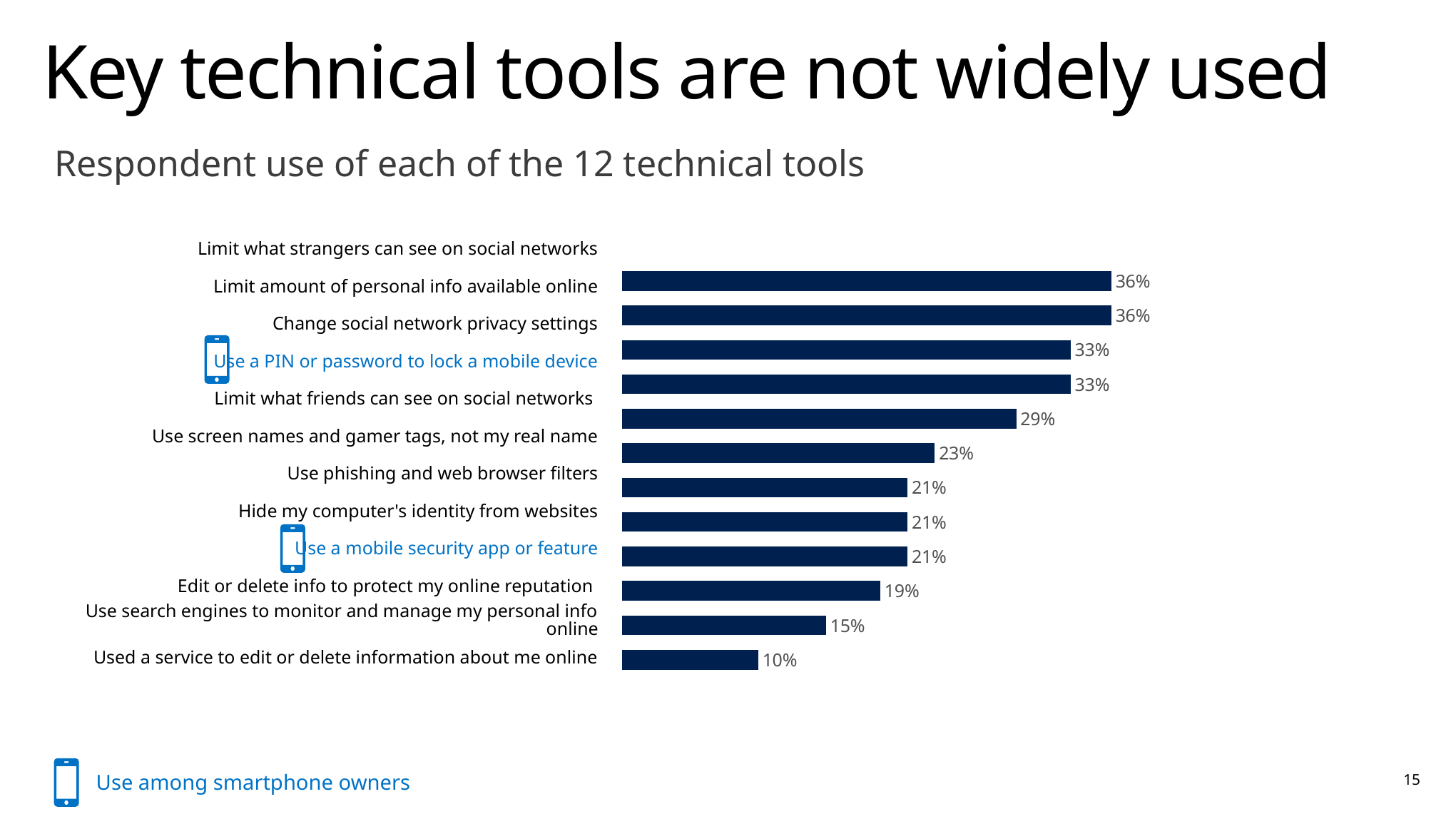
What is the value for "Edit or delete info to protect my online reputation"? 19% What is the value for "Use a mobile security app or feature"? 21% What is the value for "Limit amount of personal info available online"? 36% What kind of chart is shown on the slide? Bar chart What is the value for "Used a service to edit or delete information about me online"? 10% What is the value for "Use search engines to monitor and manage my personal info online"? 15% What does the smartphone icon next to certain labels indicate, according to the legend at the bottom of the slide? Use among smartphone owners How many technical tools (categories) are plotted in the chart? 12 What is the difference between the value for "Limit amount of personal info available online" and the value for "Used a service to edit or delete information about me online"? 26 percentage points What is the value for "Use a PIN or password to lock a mobile device"? 33% Which technical tool has the lowest value in the chart? Used a service to edit or delete information about me online Which is larger: the value for "Limit amount of personal info available online" or the value for "Use a mobile security app or feature"? Limit amount of personal info available online